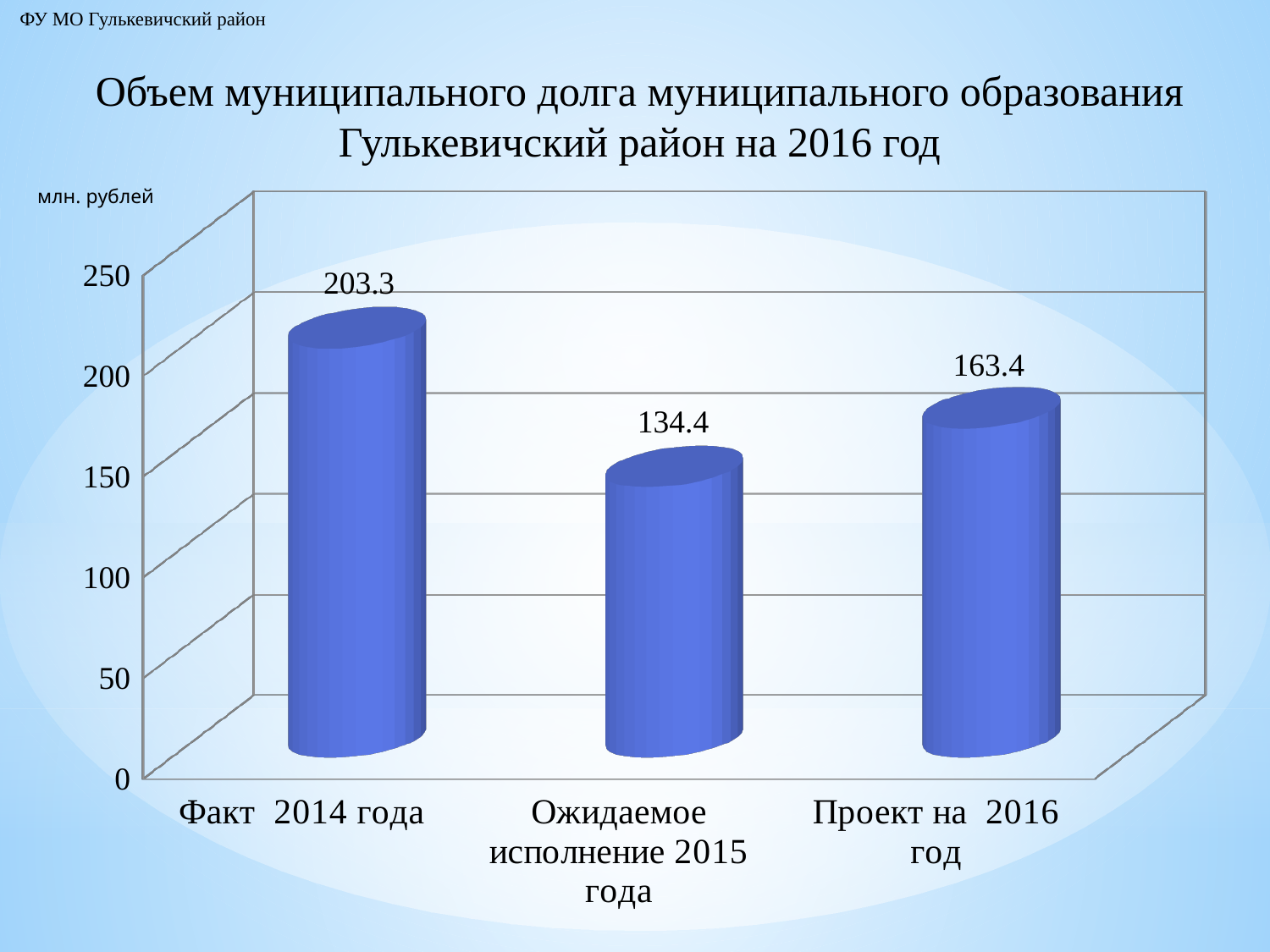
What is the value for Факт 2014 года? 203.3 How many categories are shown on the chart? 3 What is the difference between the values for Факт 2014 года and Ожидаемое исполнение 2015 года? 68.9 What is the value for Ожидаемое исполнение 2015 года? 134.4 Is the value for Факт 2014 года greater or less than 200? greater Which category has the highest value? Факт 2014 года What unit is shown on the chart's vertical axis? млн. рублей What is the difference between the values for Проект на 2016 год and Ожидаемое исполнение 2015 года? 29.0 Which category has the lowest value? Ожидаемое исполнение 2015 года Which is larger, the value for Проект на 2016 год or the value for Ожидаемое исполнение 2015 года? Проект на 2016 год What is the value for Проект на 2016 год? 163.4 What kind of chart is shown on the slide? bar chart